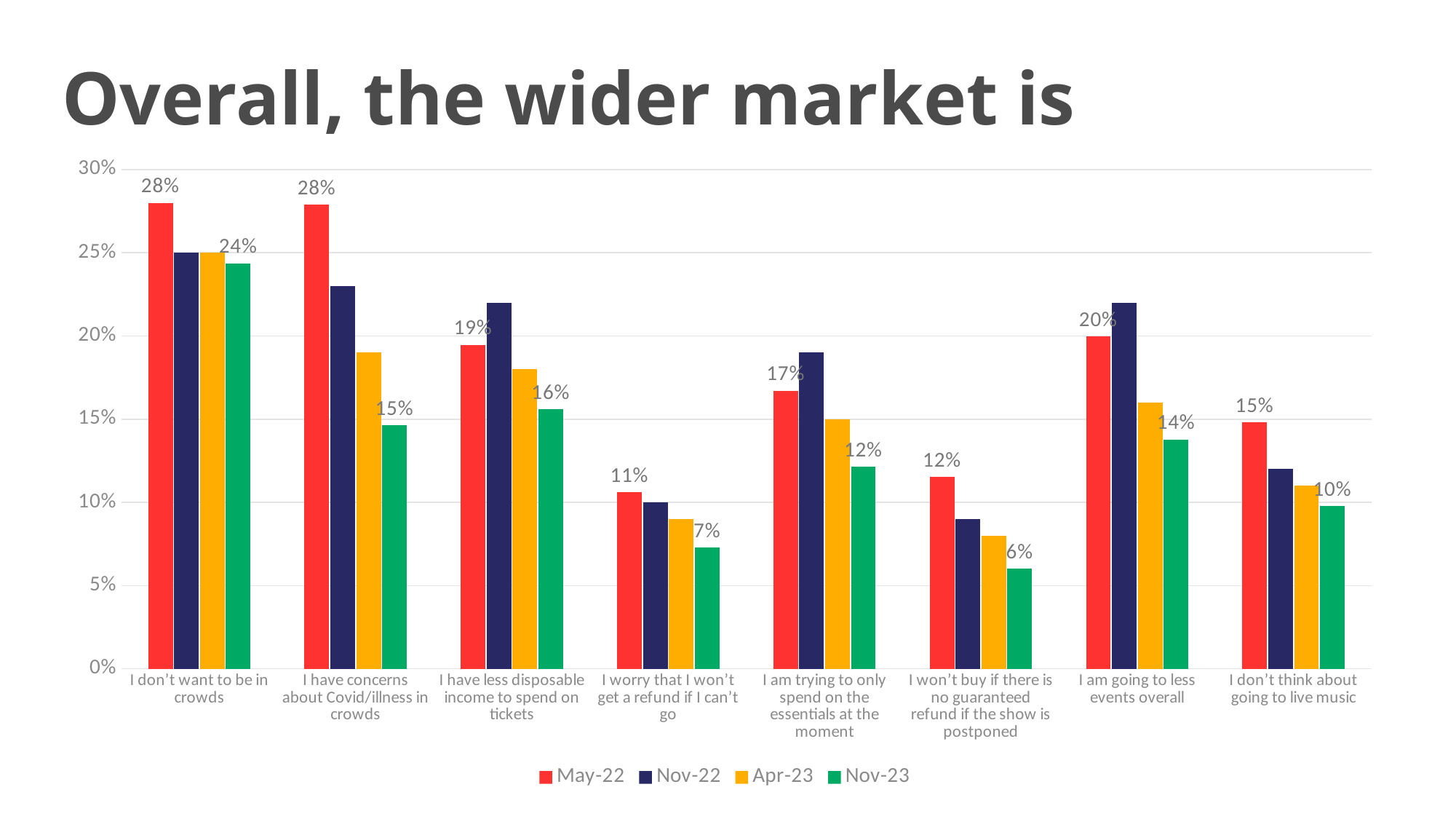
How many categories are shown on the x axis? 8 What is the difference between the May-22 and Nov-23 values for "I have concerns about Covid/illness in crowds"? 13% What is the Nov-23 value for "I won't buy if there is no guaranteed refund if the show is postponed"? 6% What is the May-22 value for "I don't want to be in crowds"? 28% Is the Nov-22 value for "I have less disposable income to spend on tickets" greater or less than 20%? greater Which category has the highest Nov-23 value? I don't want to be in crowds How many series does the legend list? 4 What is the Nov-23 value for "I have concerns about Covid/illness in crowds"? 15% What kind of chart is shown on the slide? Bar chart What is the May-22 value for "I am going to less events overall"? 20% Which category has the lowest Nov-23 value? I won't buy if there is no guaranteed refund if the show is postponed Which is larger for "I worry that I won't get a refund if I can't go": the May-22 value or the Nov-23 value? May-22